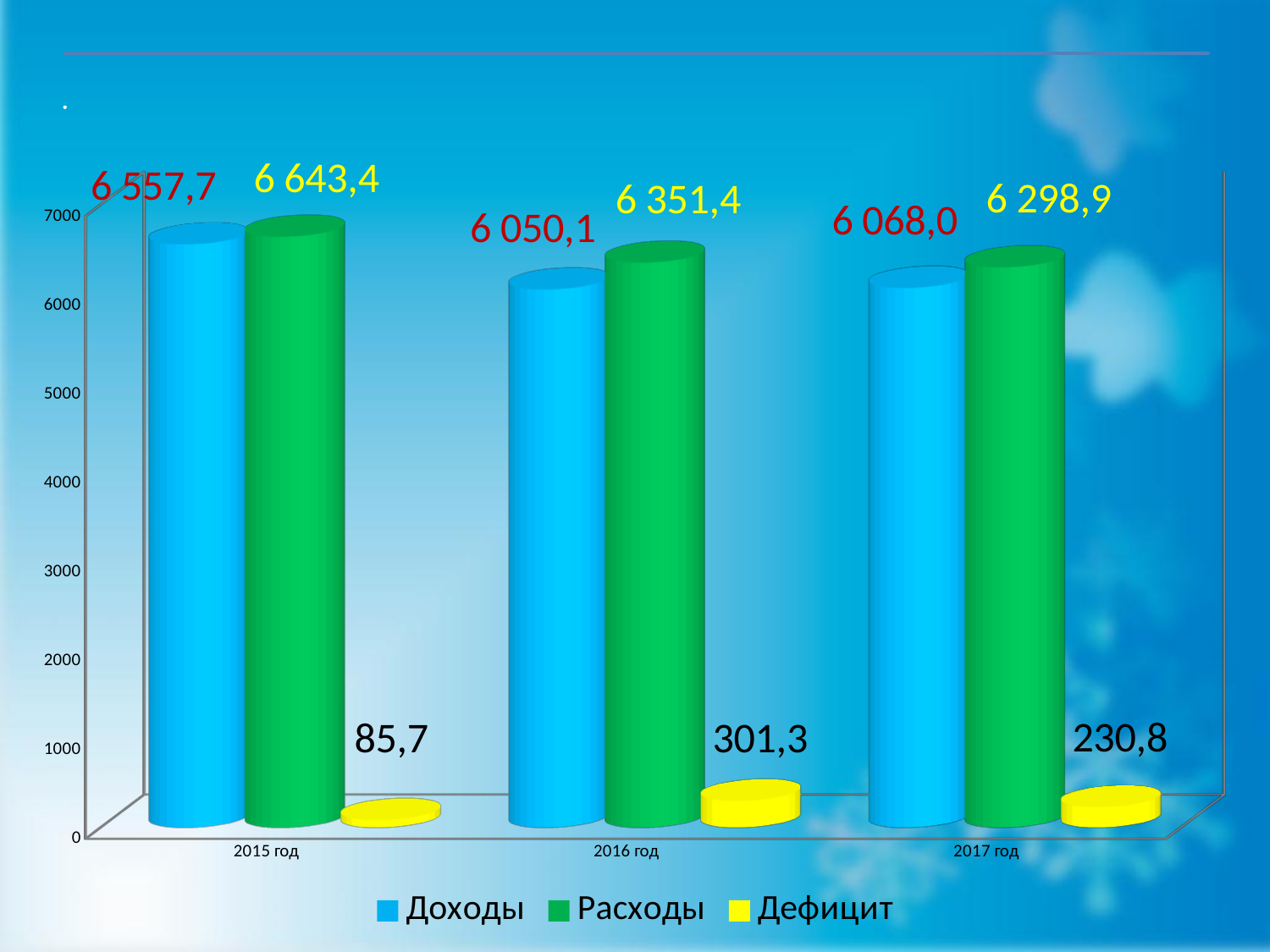
Is the value of Расходы for 2017 год greater or less than 6000? greater How many series does the legend list? 3 What is the value of Дефицит for 2017 год? 230,8 In which year is Доходы the lowest? 2016 год How many years are shown on the x axis? 3 What is the value of Доходы for 2015 год? 6 557,7 Which colour represents Дефицит in the legend? yellow What is the difference between Расходы and Доходы for 2015 год? 85,7 What is the value of Расходы for 2016 год? 6 351,4 Which is larger for 2017 год, Доходы or Расходы? Расходы What kind of chart is shown on the slide? bar chart In which year is Дефицит the highest? 2016 год